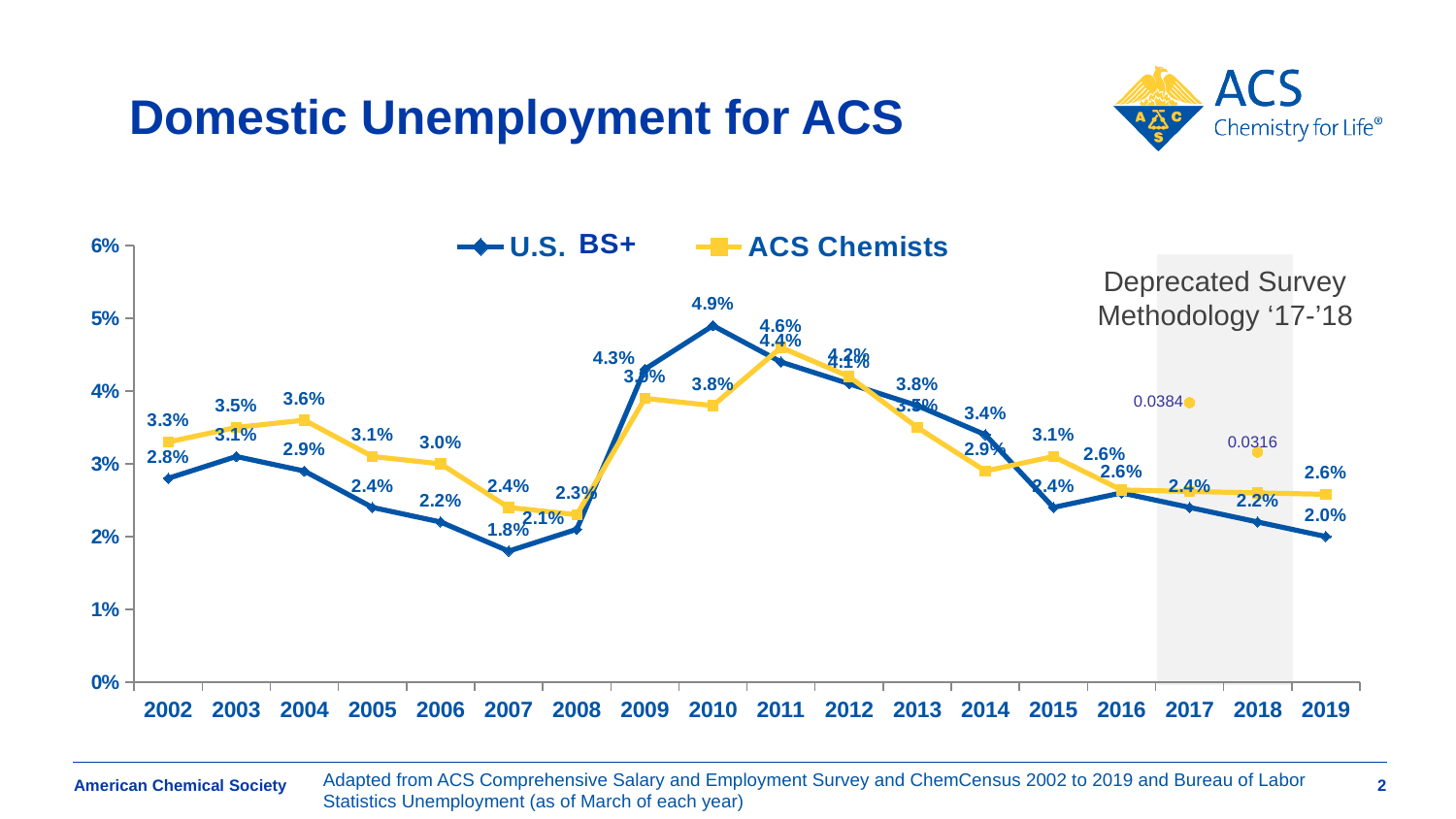
In 2014, which series has the higher value, U.S. BS+ or ACS Chemists? U.S. BS+ In which year does the ACS Chemists series reach its highest value? 2011 What kind of chart is shown on the slide? Line chart What is the ACS Chemists unemployment value for 2004? 3.6% In which year is the U.S. BS+ series at its lowest? 2007 What is the U.S. BS+ unemployment value for 2010? 4.9% What is the difference between the U.S. BS+ and ACS Chemists values in 2010? 1.1 percentage points Does the U.S. BS+ series rise or fall from 2016 to 2019? Fall How many years are plotted along the x axis? 18 In which year is the U.S. BS+ series at its highest? 2010 What is the ACS Chemists value for 2019? 2.6% How many series does the legend list? 2